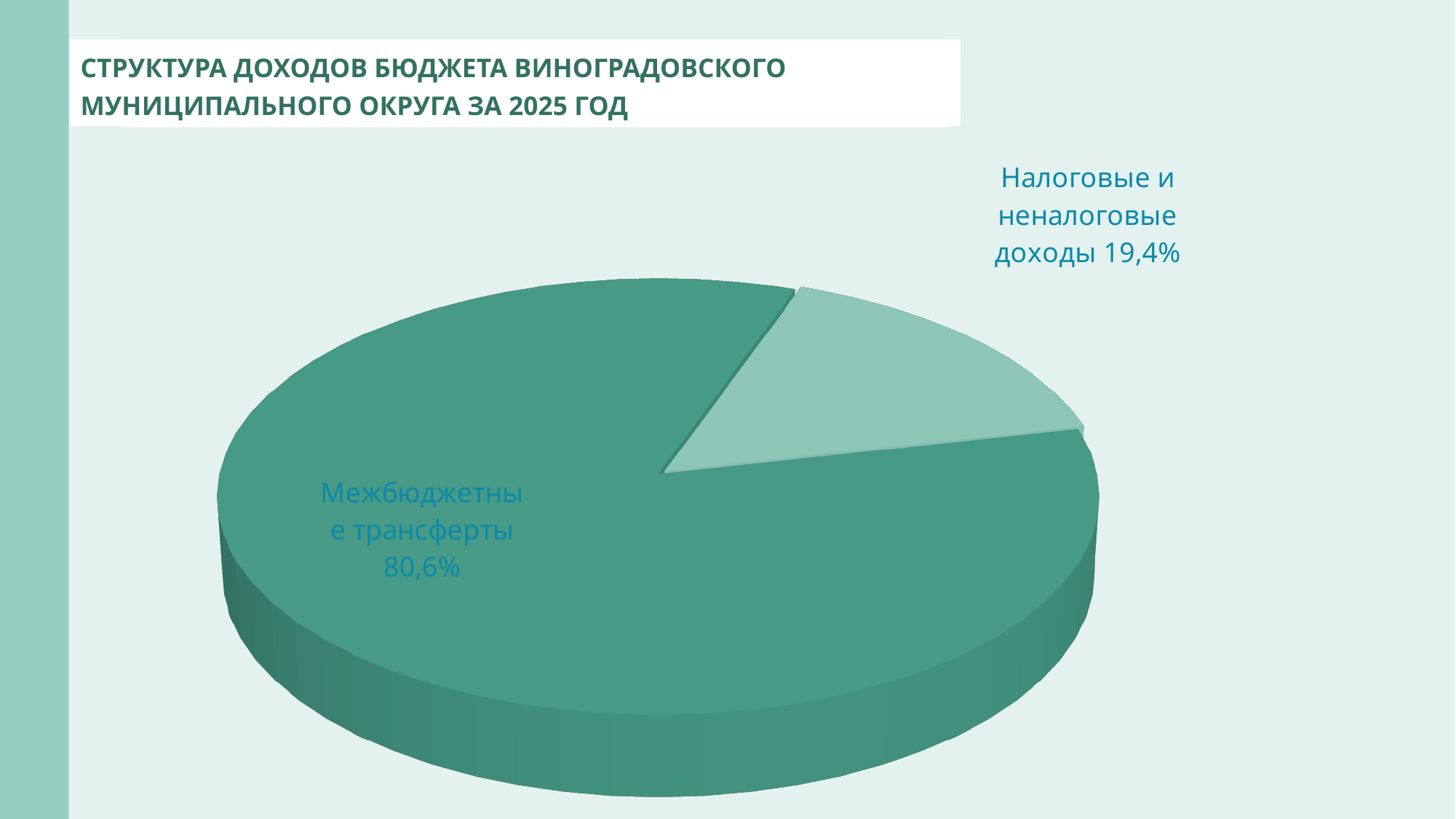
Which category has the smallest slice of the pie? Налоговые и неналоговые доходы What share of the pie is labelled for Налоговые и неналоговые доходы? 19,4% Which category has the largest slice of the pie? Межбюджетные трансферты Which is larger: the share for Межбюджетные трансферты or the share for Налоговые и неналоговые доходы? Межбюджетные трансферты What is the difference in percentage points between the Межбюджетные трансферты slice and the Налоговые и неналоговые доходы slice? 61,2 What share of the pie is labelled for Межбюджетные трансферты? 80,6% Which year does the chart's title refer to? 2025 What is the total of the two labelled shares in the pie chart? 100% What kind of chart is shown on the slide? Pie chart What is the title of the slide containing the chart? СТРУКТУРА ДОХОДОВ БЮДЖЕТА ВИНОГРАДОВСКОГО МУНИЦИПАЛЬНОГО ОКРУГА ЗА 2025 ГОД How many slices does the pie chart have? 2